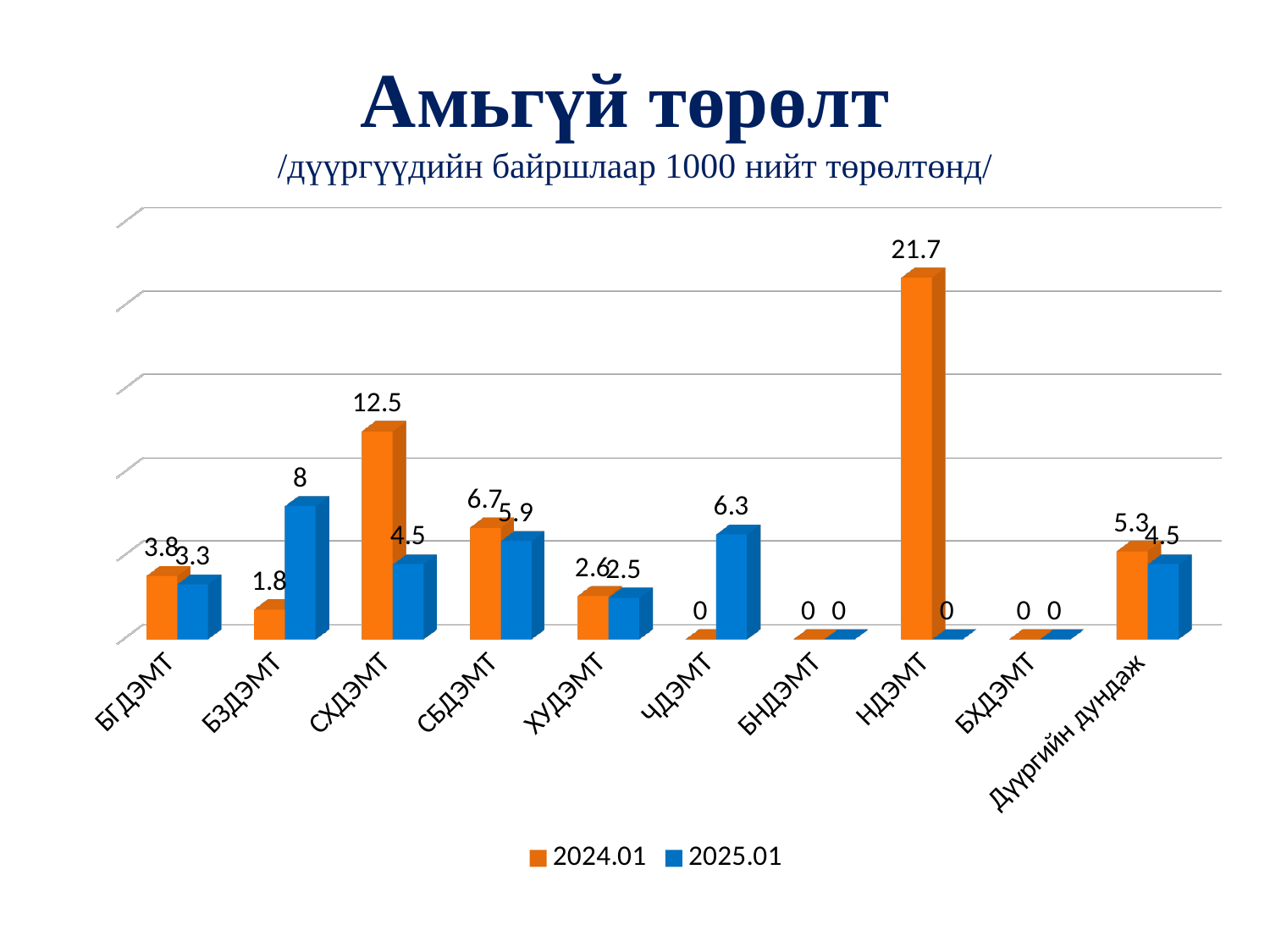
What is the 2025.01 value for Дүүргийн дундаж? 4.5 What is the 2024.01 value for НДЭМТ? 21.7 What kind of chart is shown on the slide? Bar chart What is the 2025.01 value for БЗДЭМТ? 8 What is the difference between the 2024.01 and 2025.01 values for СХДЭМТ? 8 How many series does the legend list? 2 What is the 2024.01 value for СХДЭМТ? 12.5 Which category has the highest 2025.01 value? БЗДЭМТ How many categories are shown on the x axis? 10 For СБДЭМТ, which series has the larger value, 2024.01 or 2025.01? 2024.01 What is the difference between the 2025.01 and 2024.01 values for БЗДЭМТ? 6.2 Which category has the highest 2024.01 value? НДЭМТ